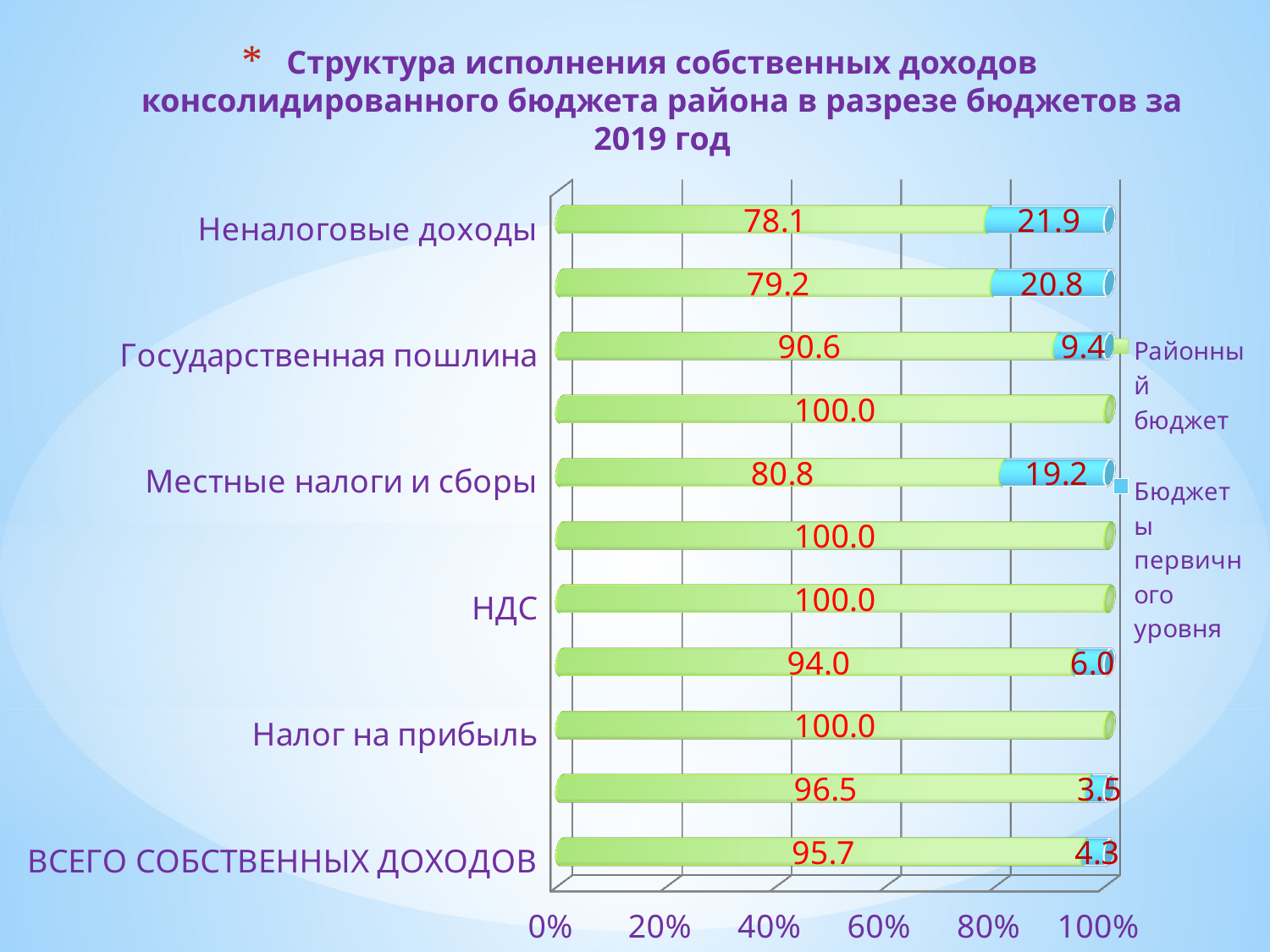
How many series does the legend list? 2 What is the value of Районный бюджет for ВСЕГО СОБСТВЕННЫХ ДОХОДОВ? 95.7 What is the value of Бюджеты первичного уровня for Государственная пошлина? 9.4 Which is larger: the Бюджеты первичного уровня value for Неналоговые доходы or for Местные налоги и сборы? Неналоговые доходы What is the value of Районный бюджет for НДС? 100.0 What kind of chart is shown on the slide? Stacked bar chart What is the value of Бюджеты первичного уровня for Неналоговые доходы? 21.9 What is the value of Районный бюджет for Неналоговые доходы? 78.1 What is the total of the stacked bar for ВСЕГО СОБСТВЕННЫХ ДОХОДОВ? 100.0 How many bars are plotted in the chart? 11 What is the difference between the Районный бюджет values for Государственная пошлина and Неналоговые доходы? 12.5 What is the value of Районный бюджет for Местные налоги и сборы? 80.8